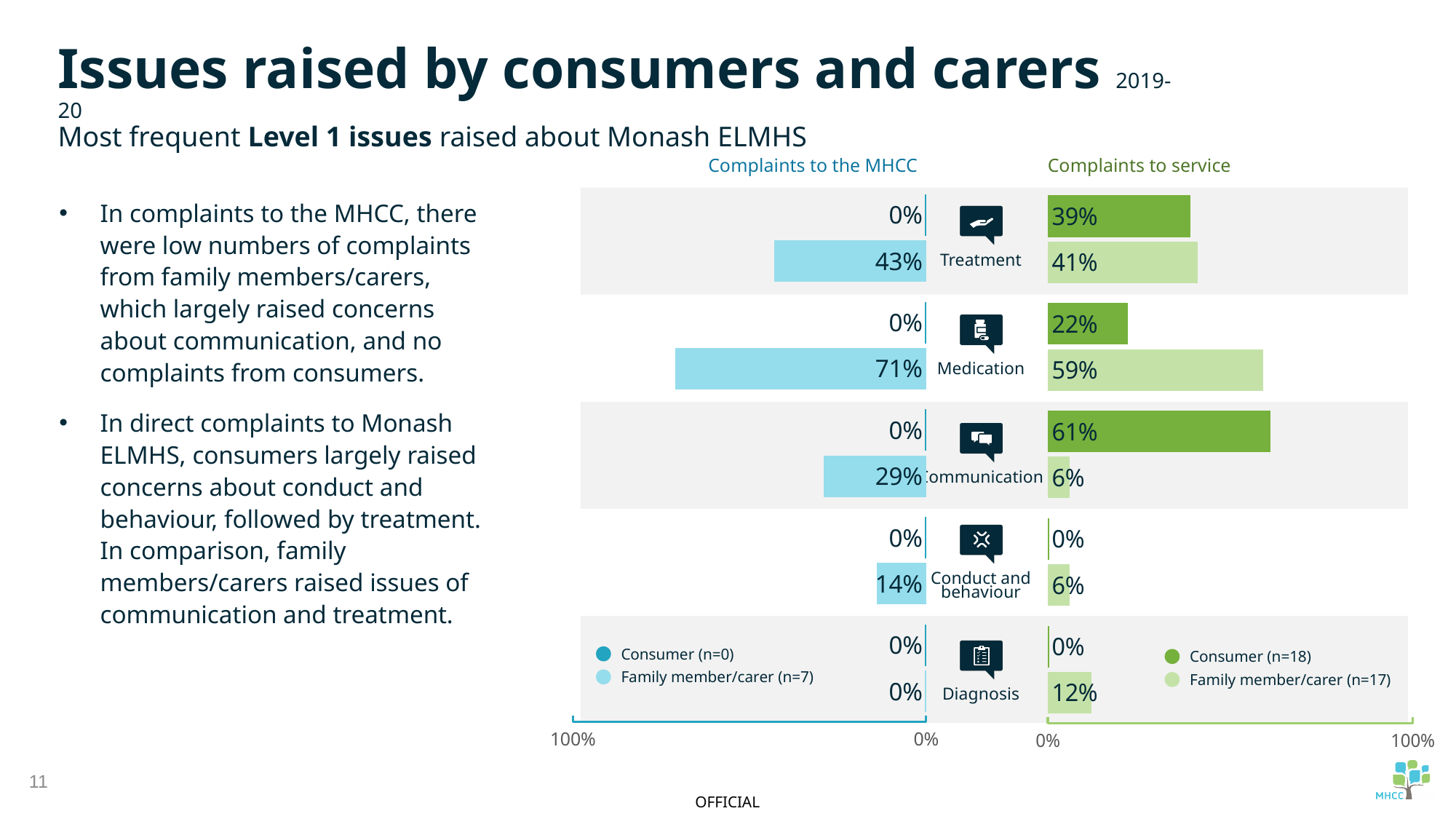
In the 'Complaints to service' chart, which issue has the lowest Family member/carer value? Communication and Conduct and behaviour (both 6%) How many series does the legend of the 'Complaints to service' chart list? 2 According to the legend of the 'Complaints to service' chart, how many consumers are in the sample? n=18 In the 'Complaints to service' chart, what is the value for Family member/carer for Diagnosis? 12% In the 'Complaints to service' chart, what is the value for Consumer for Communication? 61% In the 'Complaints to the MHCC' chart, what is the difference between the Family member/carer values for Treatment and Conduct and behaviour? 29% In the 'Complaints to the MHCC' chart, what is the value for Family member/carer for Medication? 71% What kind of chart is the 'Complaints to the MHCC' chart? Bar chart In the 'Complaints to the MHCC' chart, which issue has the highest Family member/carer value? Medication How many issue categories are shown in the charts? 5 In the 'Complaints to service' chart, which is larger for Treatment: the Consumer value or the Family member/carer value? Family member/carer In the 'Complaints to service' chart, what is the difference between the Family member/carer and Consumer values for Medication? 37%